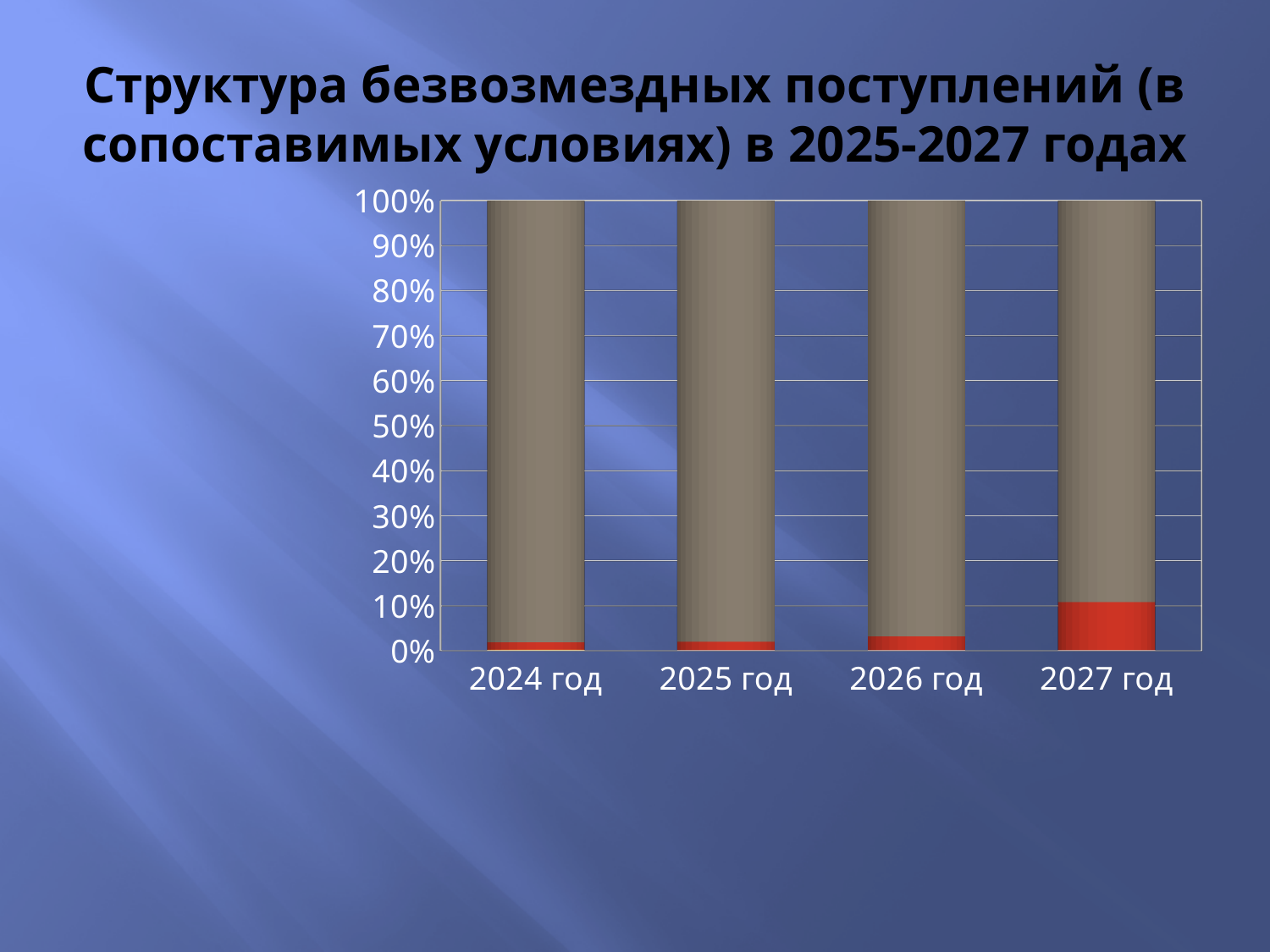
Which is larger, the red segment for 2027 год or for 2026 год? 2027 год Is the red segment for 2027 год greater or less than 20%? less Which year has the largest red segment? 2027 год What is the title of the chart on the slide? Структура безвозмездных поступлений (в сопоставимых условиях) в 2025-2027 годах What is the highest value shown on the vertical axis? 100% Which is larger, the grey segment for 2024 год or for 2027 год? 2024 год How many years (categories) are shown on the x axis? 4 Is the red segment for 2024 год greater or less than 10%? less Does the red segment rise or fall from 2024 год to 2027 год? Rises What is the total height of the stacked bar for 2025 год? 100% What kind of chart is shown on the slide? Stacked bar chart Is the grey segment for 2027 год greater or less than 80%? greater